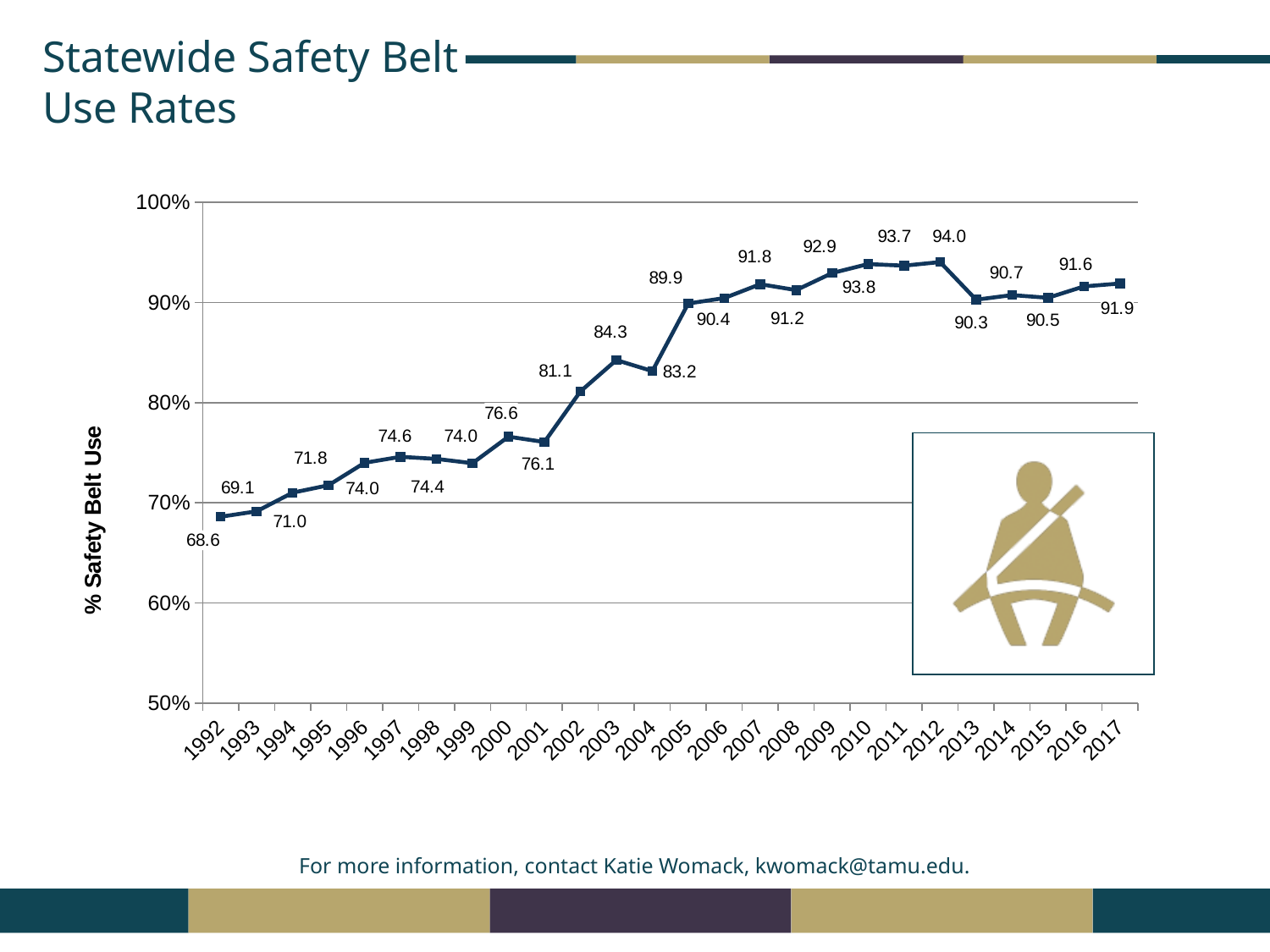
Which year has the highest safety belt use rate? 2012 What is the safety belt use rate for 2017? 91.9 What is the safety belt use rate for 2012? 94.0 What is the difference between the safety belt use rates for 2012 and 1992? 25.4 Which year has the lowest safety belt use rate? 1992 How many years are plotted on the chart? 26 What is the safety belt use rate for 1992? 68.6 Overall, do safety belt use rates rise or fall from 1992 to 2017? Rise Which year has a higher safety belt use rate, 2003 or 2004? 2003 What is the safety belt use rate for 2005? 89.9 What is the label on the vertical axis of the chart? % Safety Belt Use What kind of chart is shown on the slide? Line chart